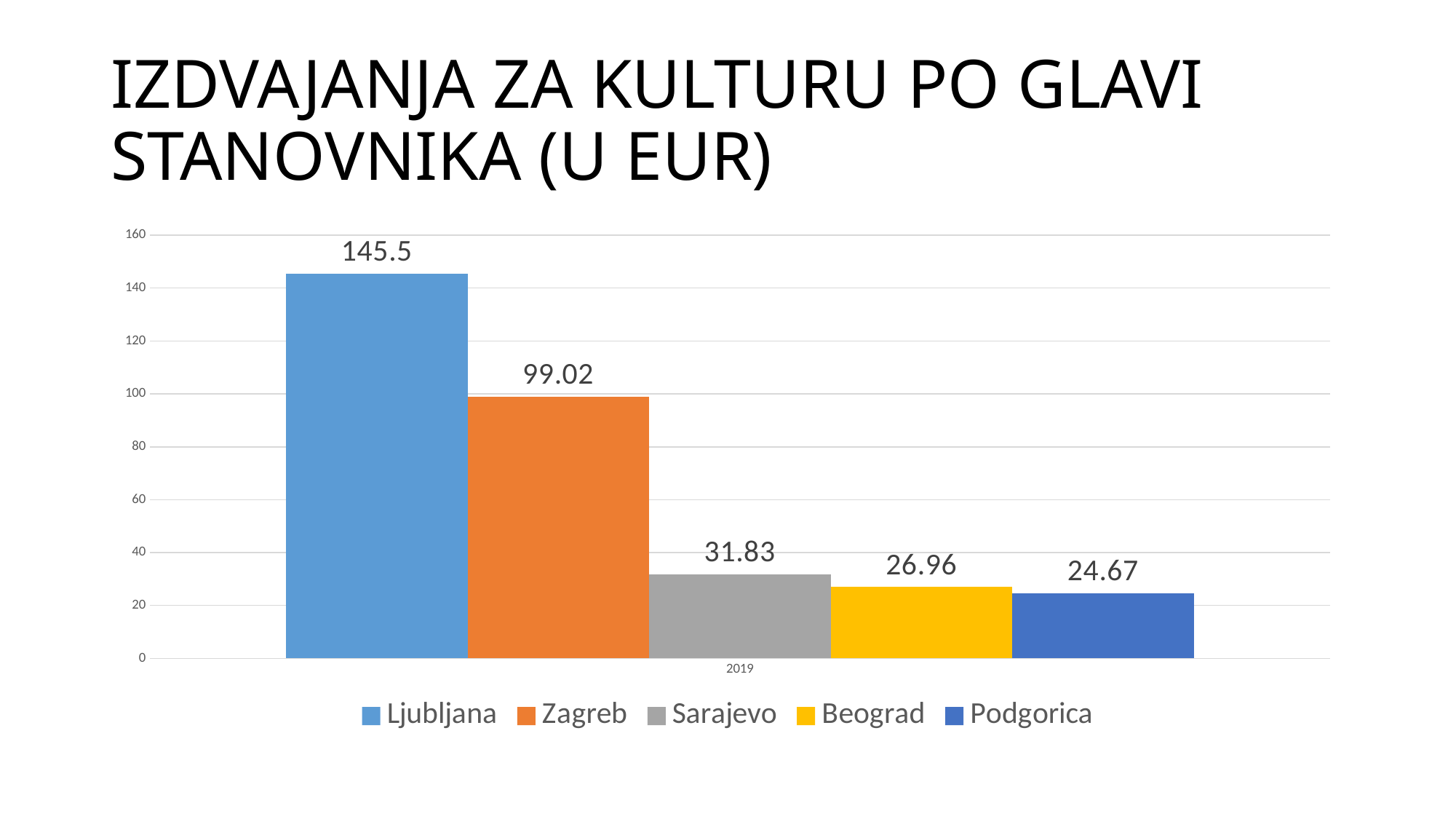
What is the value for Sarajevo? 31.83 How many series does the legend list? 5 What kind of chart is shown on the slide? Bar chart What is the value for Podgorica? 24.67 Which city has the highest value? Ljubljana Which city has the lowest value? Podgorica What is the value for Zagreb? 99.02 What is the difference between the values for Ljubljana and Zagreb? 46.48 What year is shown on the x axis of the chart? 2019 What is the difference between the values for Beograd and Podgorica? 2.29 Which is larger, the value for Sarajevo or the value for Beograd? Sarajevo What is the value for Ljubljana? 145.5